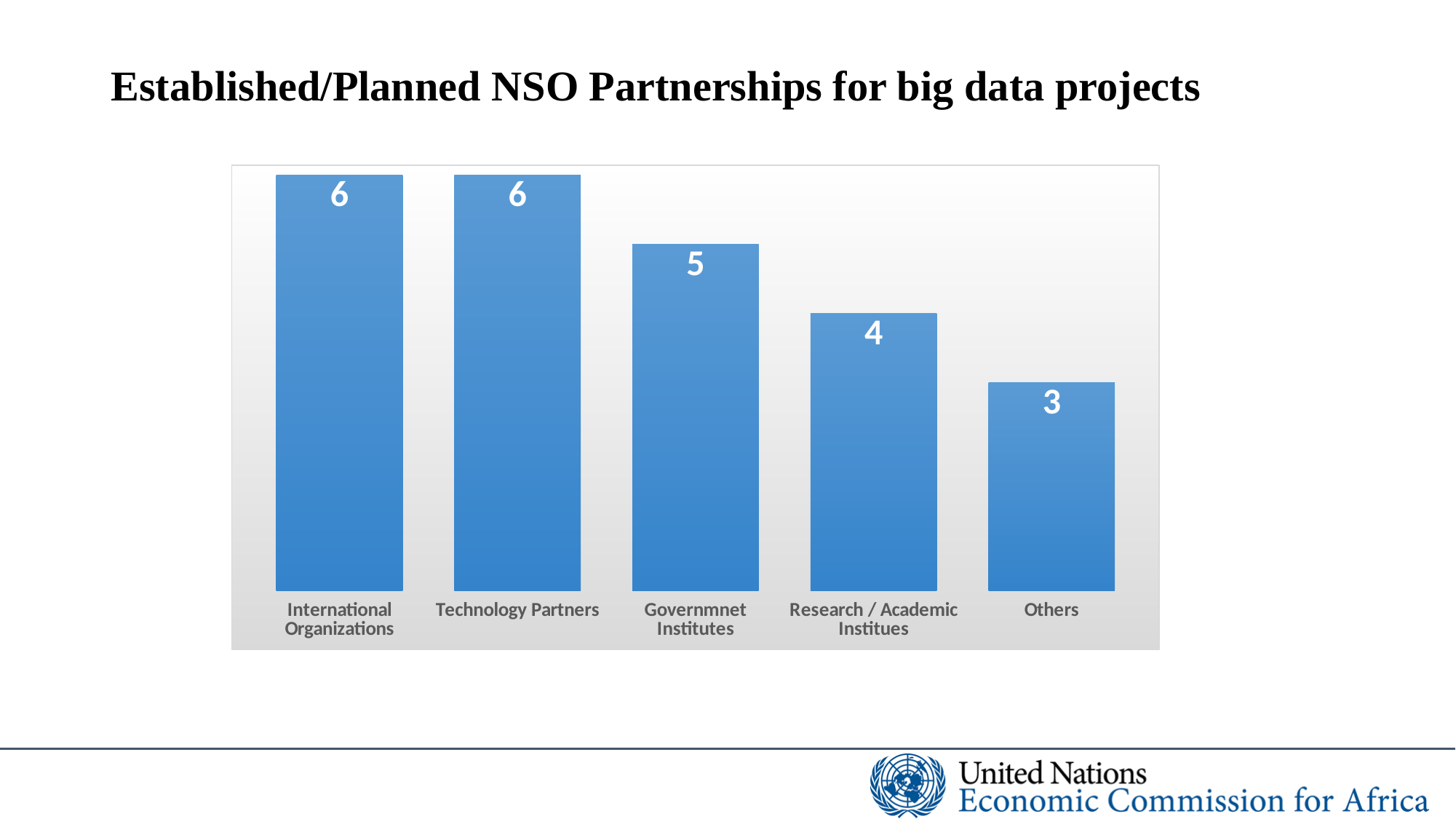
What is the value for Others? 3 How many categories are shown in the chart? 5 Which category has the lowest value? Others What is the difference between the values for International Organizations and Research / Academic Institues? 2 Do the values rise or fall from left to right across the categories? Fall What is the difference between the values for Governmnet Institutes and Others? 2 What is the value for Research / Academic Institues? 4 What kind of chart is shown on the slide? Bar chart Which is larger, the value for Governmnet Institutes or the value for Others? Governmnet Institutes What is the value for International Organizations? 6 What is the value for Technology Partners? 6 What is the value for Governmnet Institutes? 5